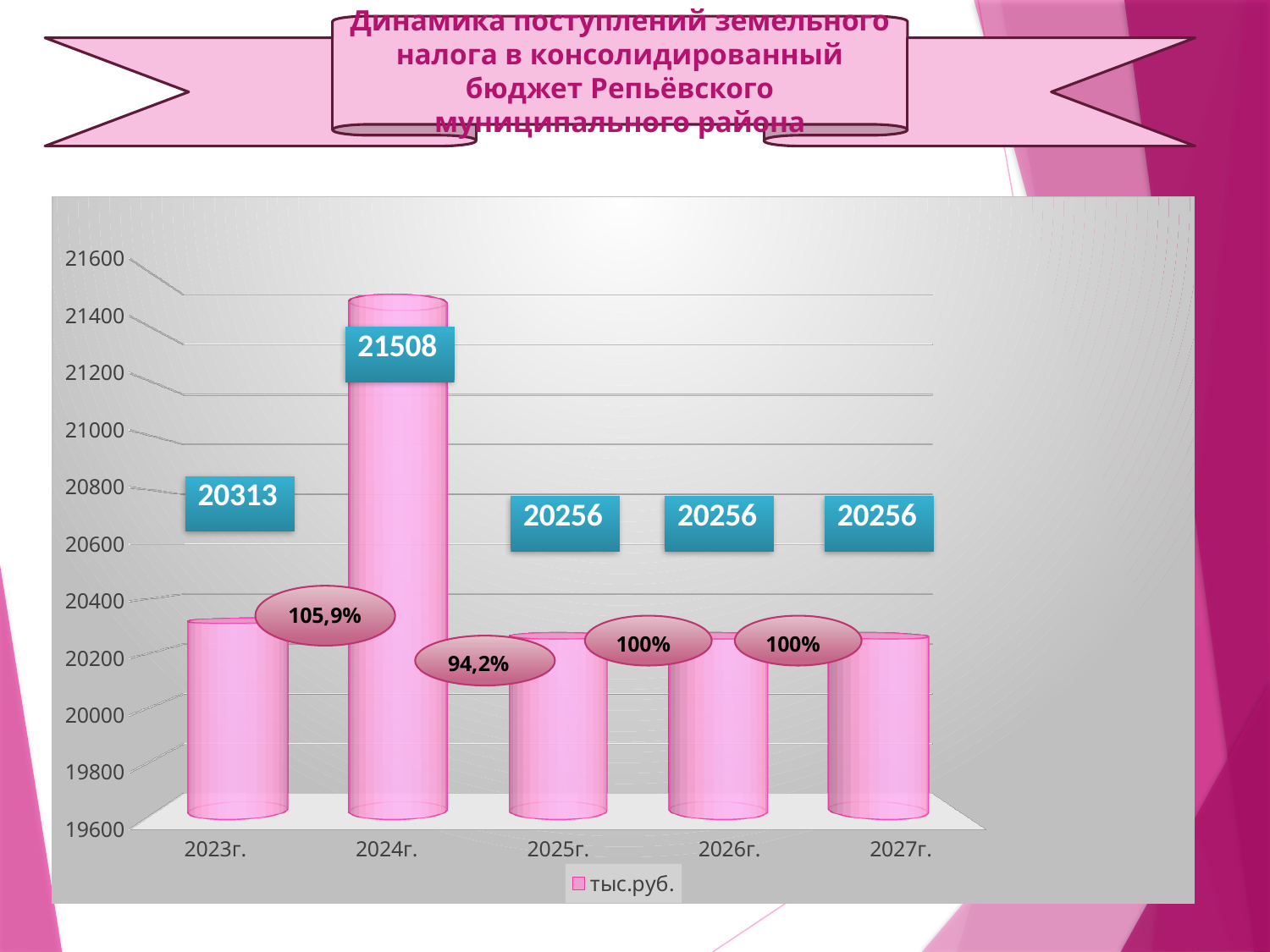
What is the value for 2023г.? 20313 Which year has the highest value? 2024г. What is the value for 2024г.? 21508 What is the difference between the values for 2023г. and 2025г.? 57 How many series does the legend list? 1 How many years are shown on the x axis? 5 What kind of chart is shown on the slide? bar chart Is the value for 2024г. greater or less than 21000? greater What is the value for 2027г.? 20256 What is the difference between the values for 2024г. and 2023г.? 1195 Which is larger, the value for 2023г. or the value for 2026г.? 2023г. What is the legend entry of the chart? тыс.руб.